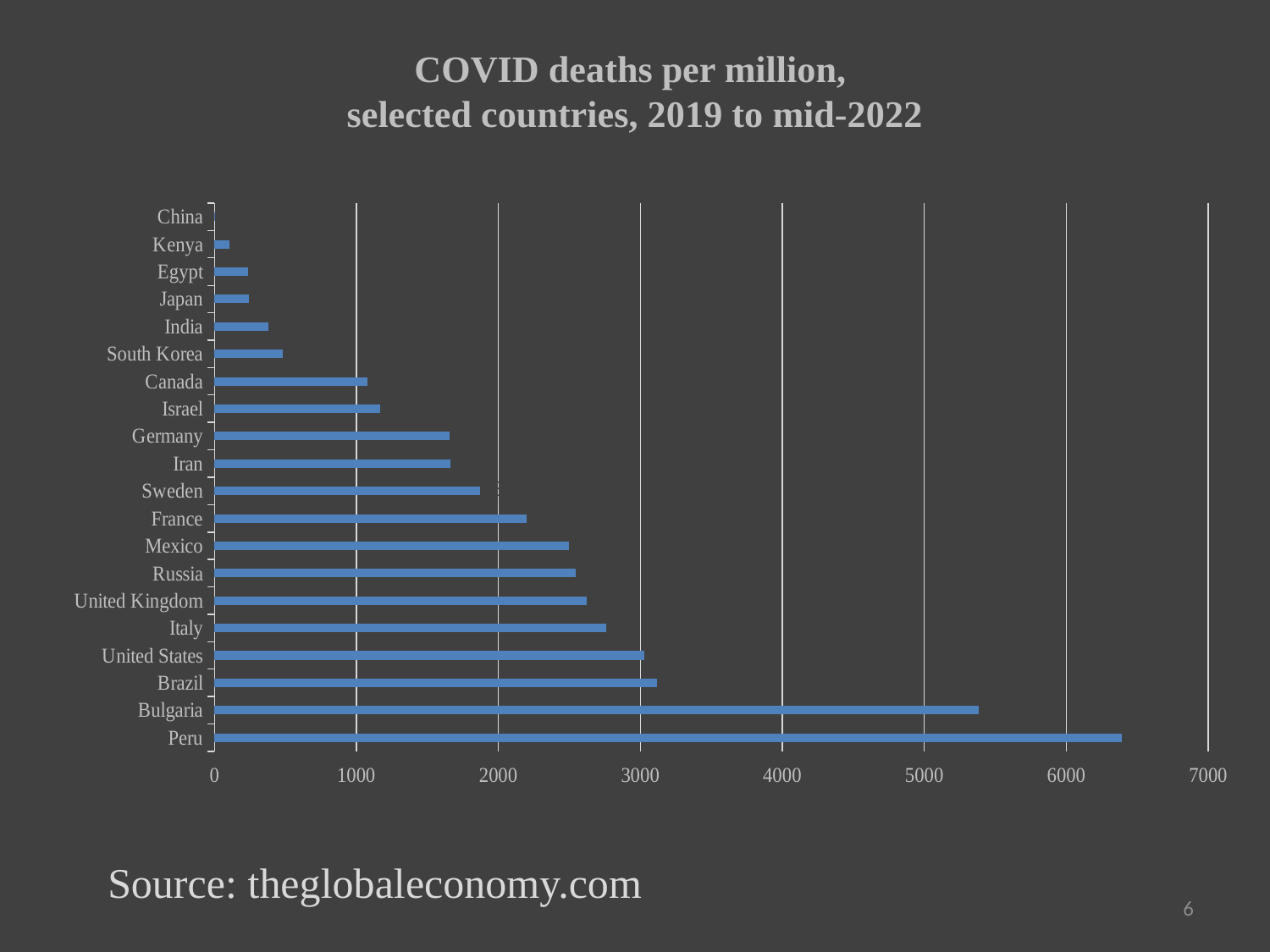
What is the title of the chart? COVID deaths per million, selected countries, 2019 to mid-2022 Is the value for Bulgaria greater or less than 5000? greater Which country has the highest COVID deaths per million? Peru Is the value for South Korea greater or less than 1000? less How many countries are shown in the chart? 20 Is the value for France greater or less than 2000? greater Which has a higher value, Bulgaria or Brazil? Bulgaria Which country has the lowest COVID deaths per million? China What kind of chart is shown on the slide? bar chart